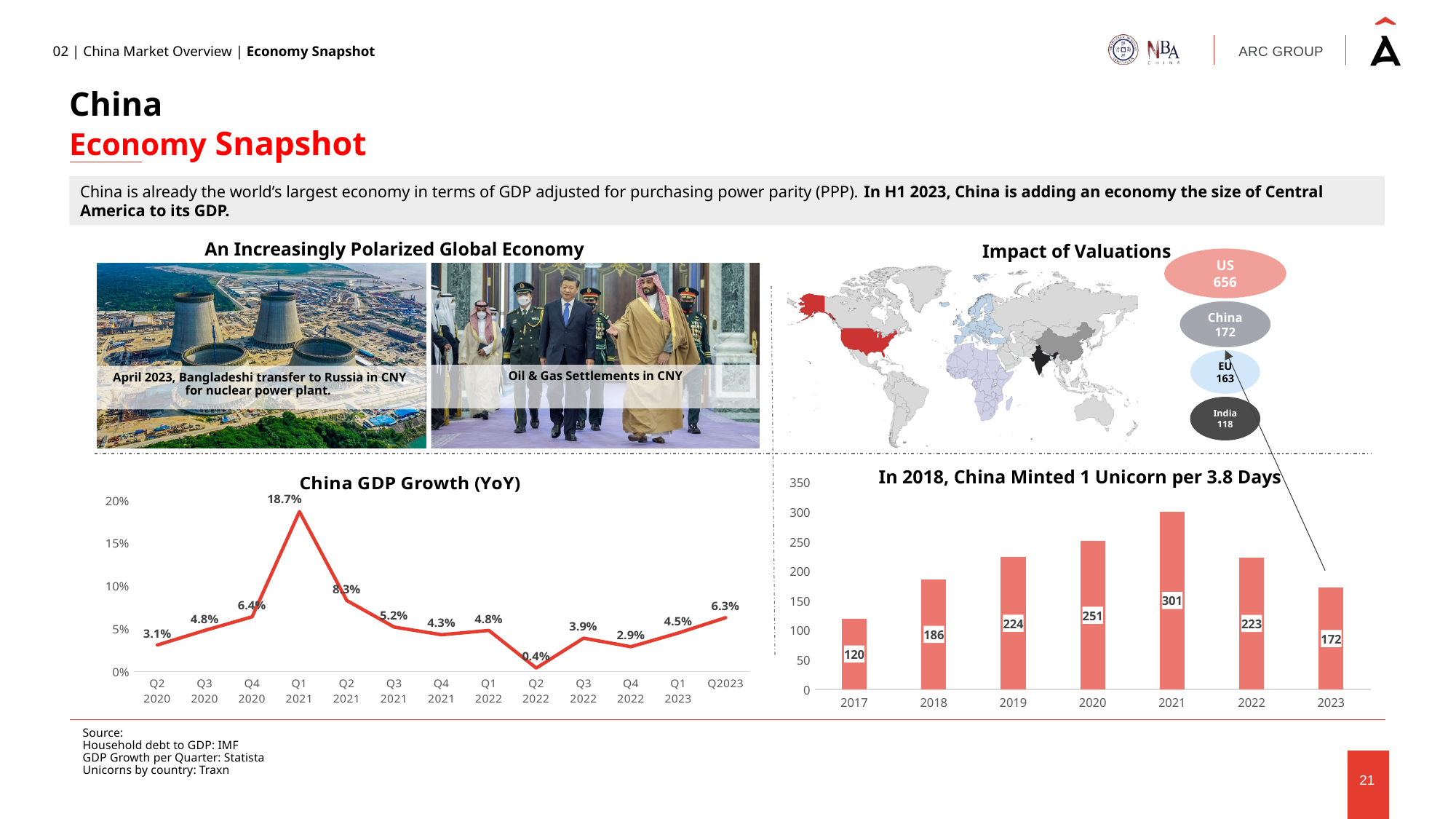
In the chart titled 'In 2018, China Minted 1 Unicorn per 3.8 Days', what is the value for 2021? 301 In the China GDP Growth (YoY) chart, how many quarters are plotted? 13 In the chart titled 'In 2018, China Minted 1 Unicorn per 3.8 Days', how many years are shown? 7 In the China GDP Growth (YoY) chart, is the value for Q4 2022 greater or less than 5%? less In the China GDP Growth (YoY) chart, what is the value for Q1 2021? 18.7% What kind of chart is the chart titled 'In 2018, China Minted 1 Unicorn per 3.8 Days'? Bar chart In the chart titled 'In 2018, China Minted 1 Unicorn per 3.8 Days', which year has the lowest value? 2017 In the chart titled 'In 2018, China Minted 1 Unicorn per 3.8 Days', what is the difference between 2021 and 2023? 129 In the China GDP Growth (YoY) chart, which quarter has the lowest growth? Q2 2022 In the chart titled 'In 2018, China Minted 1 Unicorn per 3.8 Days', which is larger, 2019 or 2022? 2019 In the China GDP Growth (YoY) chart, what is the difference between Q1 2021 and Q2 2021? 10.4% What kind of chart is the China GDP Growth (YoY) chart? Line chart